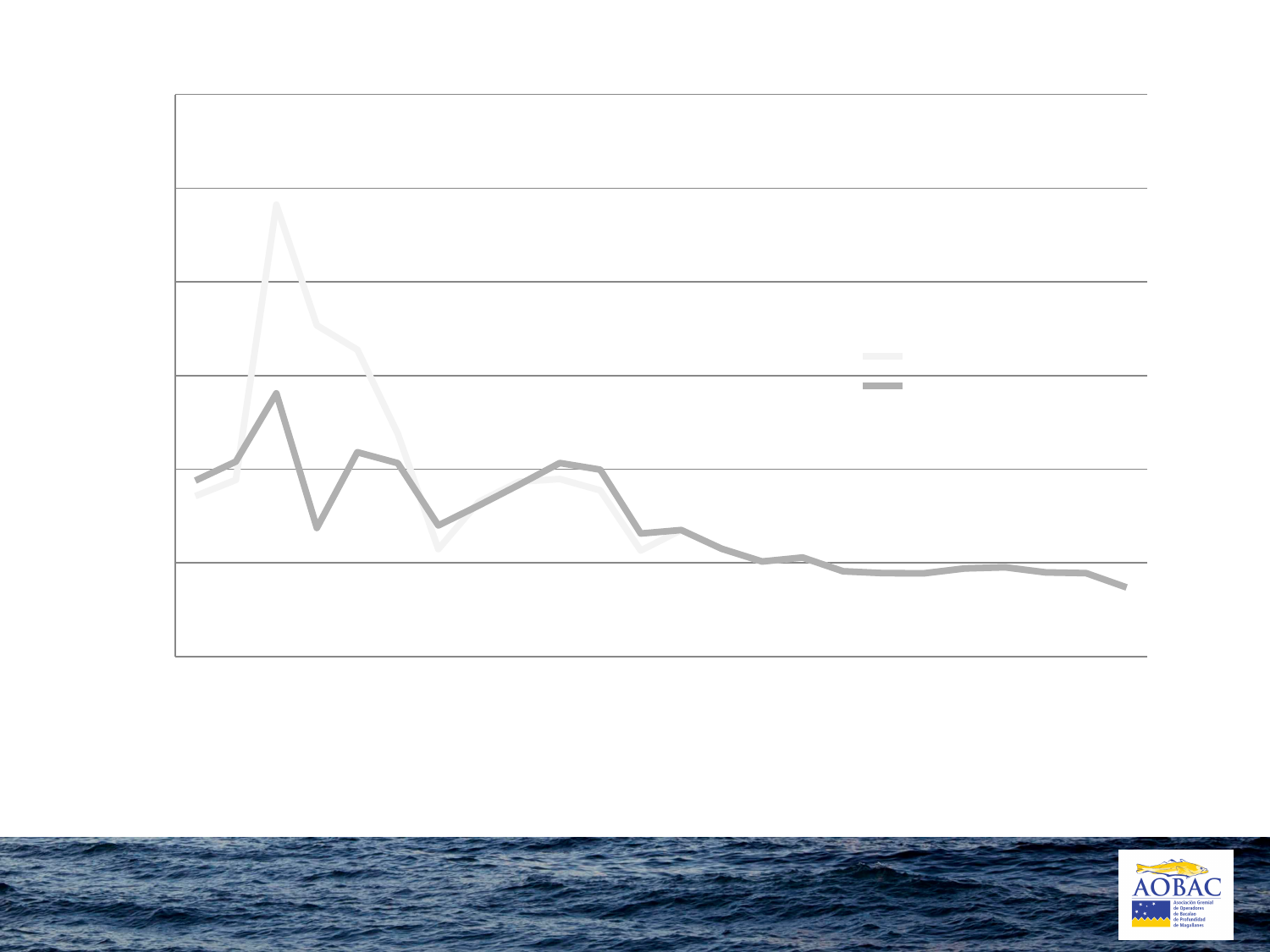
Which series extends further to the right along the x axis, the white line or the gray line? the gray line What colours are the two lines plotted on the chart? white and gray How many series does the legend list? 2 Overall, does the gray line end higher or lower than where it starts on the left? lower What kind of chart is shown on the slide? line chart Which series reaches the higher peak, the white line or the gray line? the white line